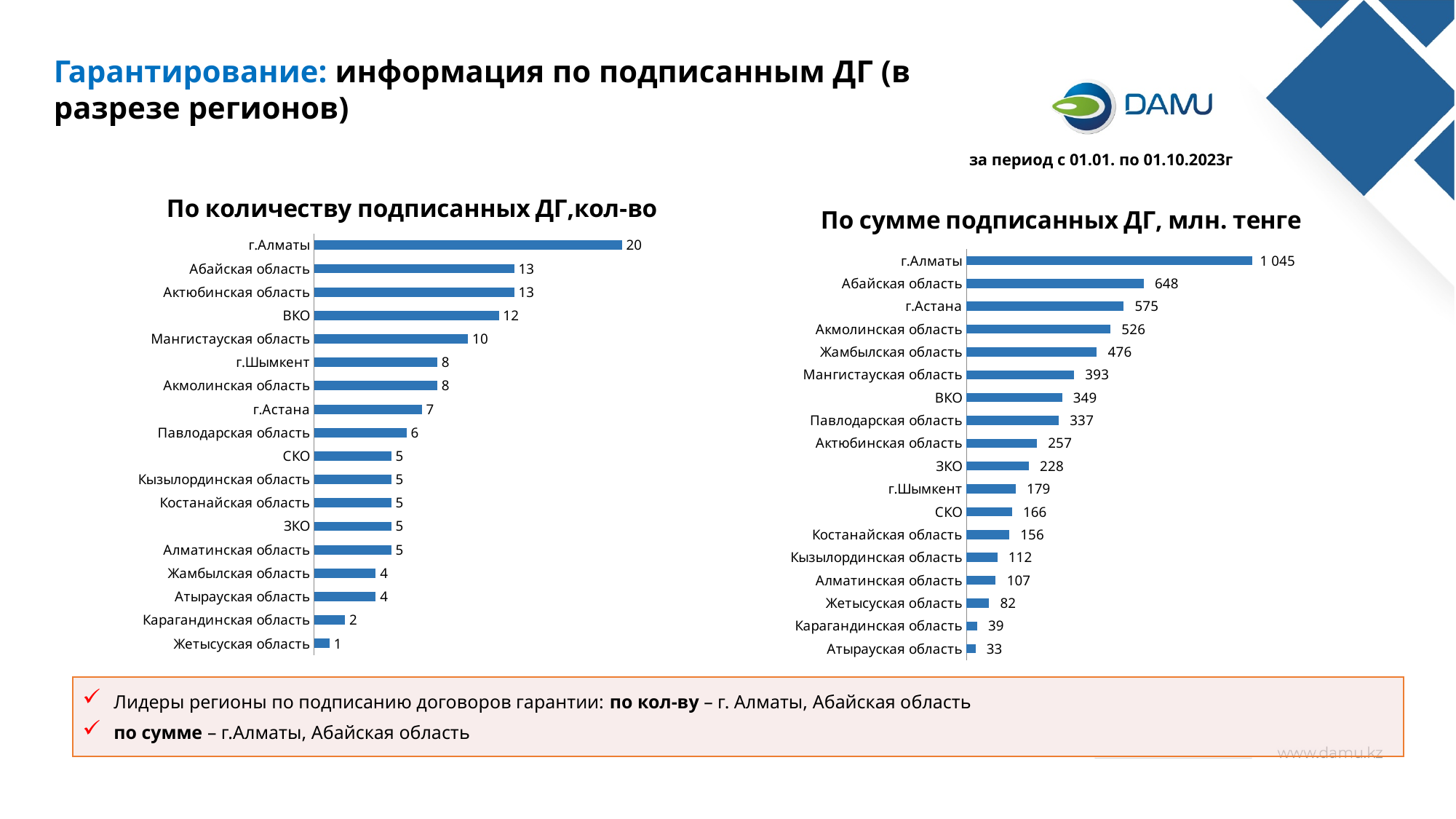
In the chart 'По сумме подписанных ДГ, млн. тенге', what is the value for Абайская область? 648 In the chart 'По количеству подписанных ДГ,кол-во', which region has the lowest value? Жетысуская область In the chart 'По сумме подписанных ДГ, млн. тенге', which region has the highest value? г.Алматы In the chart 'По сумме подписанных ДГ, млн. тенге', which is larger: Жамбылская область or Мангистауская область? Жамбылская область In the chart 'По количеству подписанных ДГ,кол-во', what is the difference between г.Алматы and ВКО? 8 What type of chart is 'По количеству подписанных ДГ,кол-во'? Bar chart How many regions are shown in the chart 'По сумме подписанных ДГ, млн. тенге'? 18 In the chart 'По количеству подписанных ДГ,кол-во', which is larger: Мангистауская область or г.Астана? Мангистауская область In the chart 'По сумме подписанных ДГ, млн. тенге', what is the value for г.Шымкент? 179 In the chart 'По сумме подписанных ДГ, млн. тенге', which region has the lowest value? Атырауская область In the chart 'По сумме подписанных ДГ, млн. тенге', what is the difference between г.Астана and Акмолинская область? 49 In the chart 'По количеству подписанных ДГ,кол-во', what is the value for г.Алматы? 20